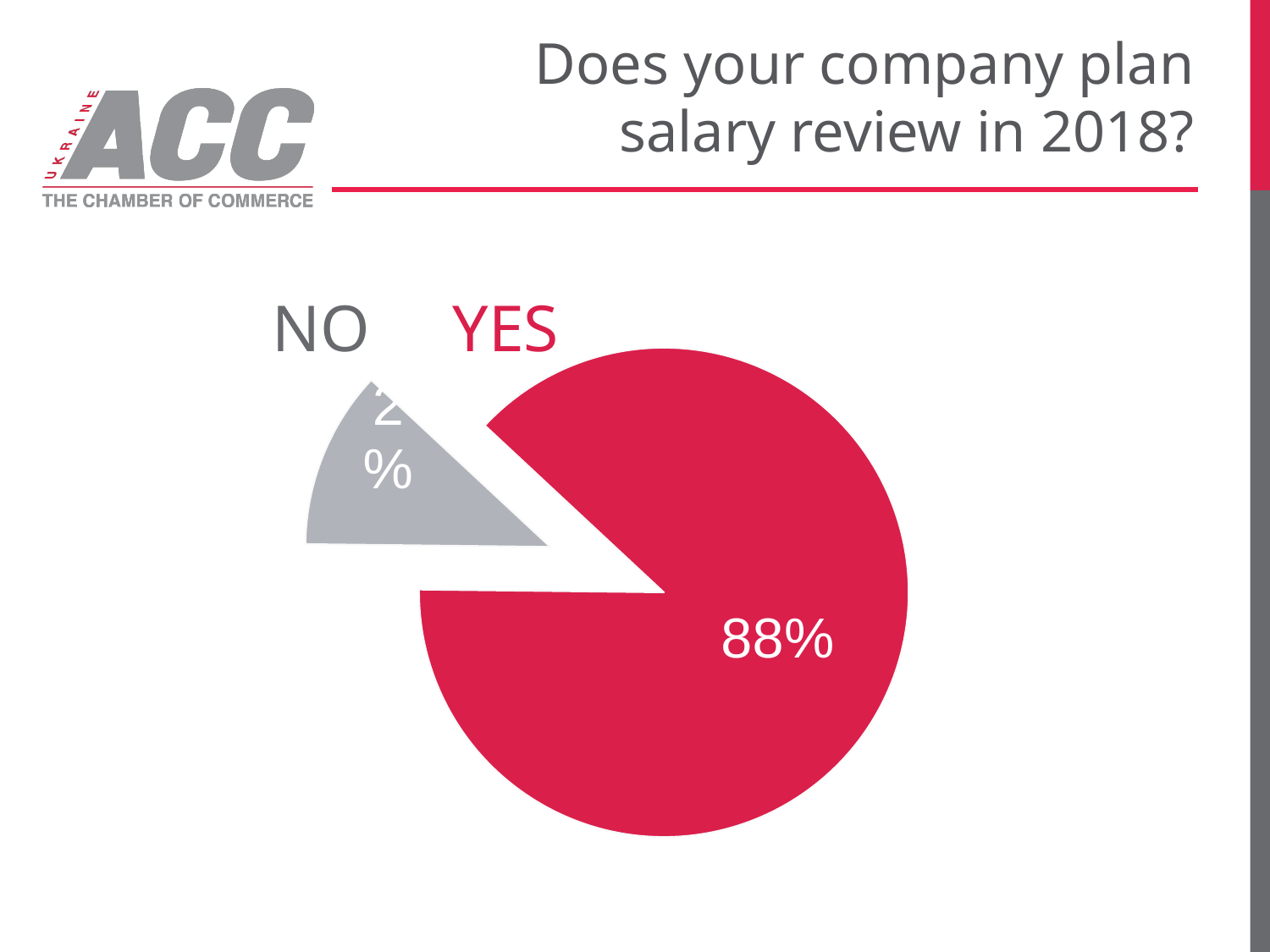
What share of the pie does the YES slice represent? 88% What kind of chart is shown on the slide? pie chart What question does the chart title ask? Does your company plan salary review in 2018? Which category has the largest slice of the pie? YES What colour is the YES slice of the pie? red Which category has the smallest slice of the pie? NO Which slice is larger, YES or NO? YES How many categories are shown in the pie chart? 2 What is the value shown for YES? 88%